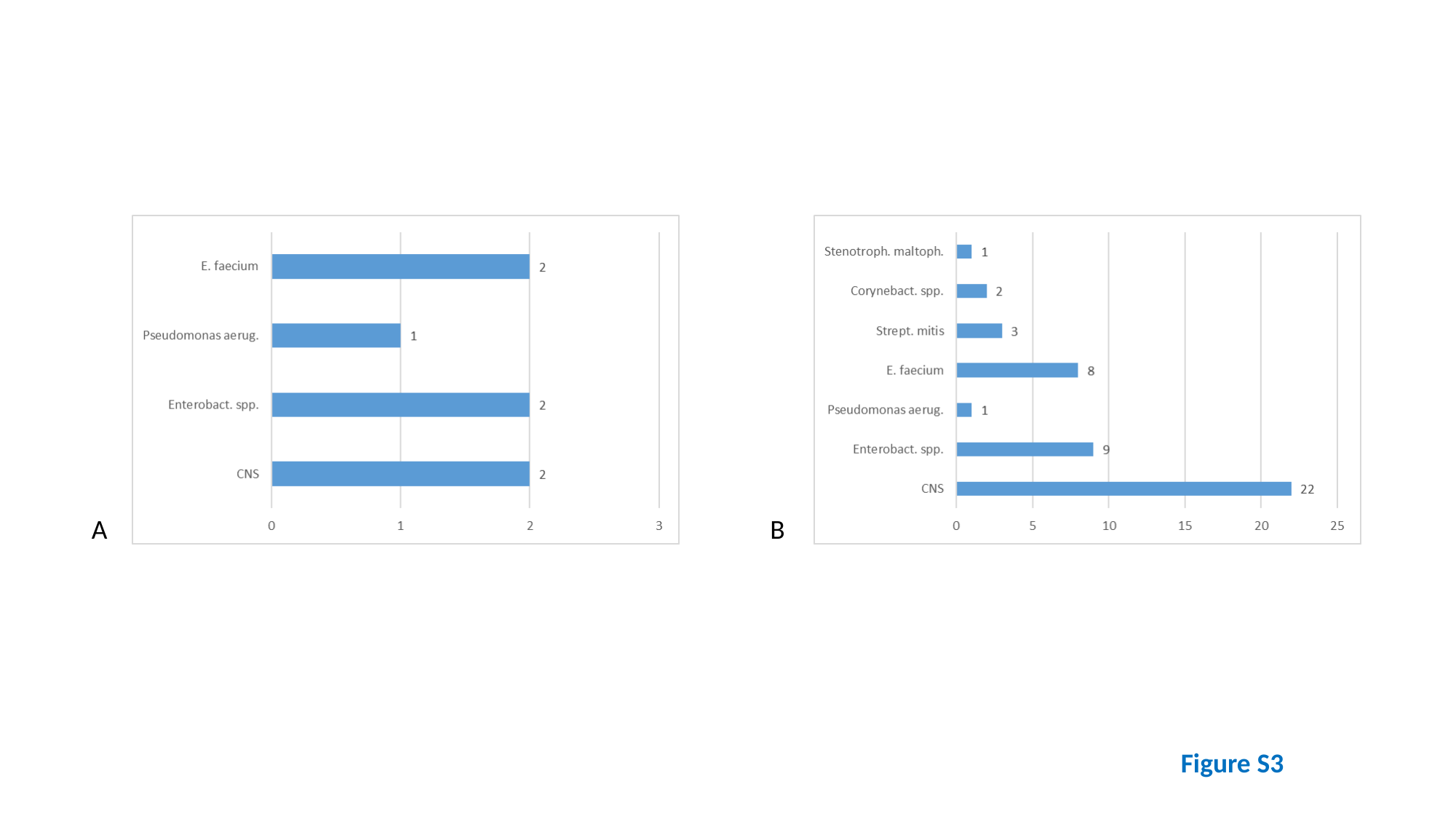
In chart A (left), what is the value for E. faecium? 2 In chart A (left), how many categories are shown? 4 In chart B (right), what is the value for Strept. mitis? 3 In chart A (left), what is the value for Pseudomonas aerug.? 1 In chart B (right), what is the difference between the values for CNS and Enterobact. spp.? 13 In chart A (left), which category has the lowest value? Pseudomonas aerug. In chart B (right), which is larger, the value for E. faecium or the value for Enterobact. spp.? Enterobact. spp. In chart B (right), which category has the highest value? CNS What kind of chart is chart B (right)? Bar chart In chart B (right), what is the value for CNS? 22 In chart B (right), how many categories are shown? 7 In chart B (right), is the value for CNS greater or less than 20? greater